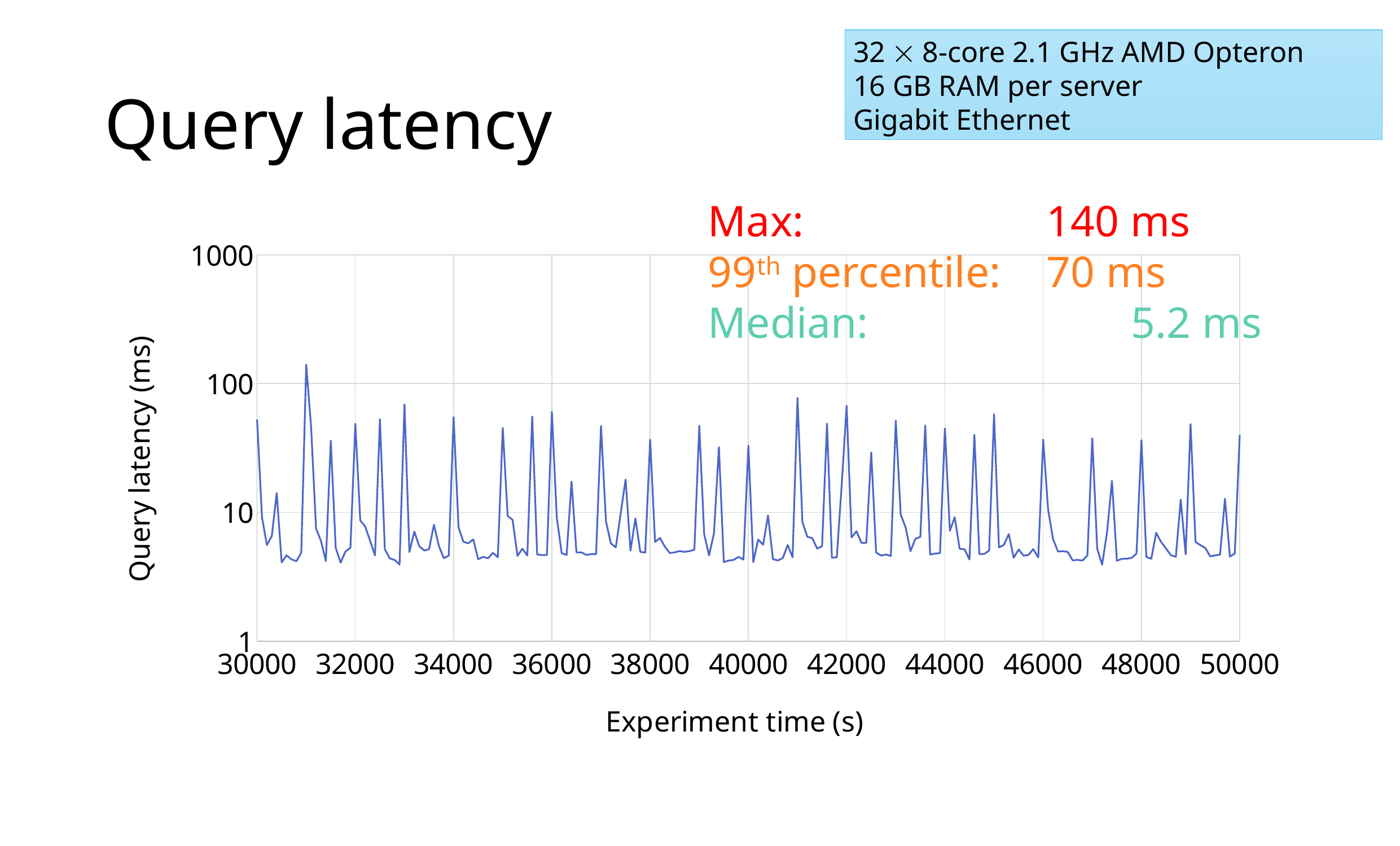
What kind of chart is shown on the slide? line chart What is the label of the x axis? Experiment time (s) Is the baseline query latency between spikes greater or less than 10 ms? less Which spike is higher: the one near 31000 s or the one near 33000 s? the one near 31000 s What is the label of the y axis? Query latency (ms) What is the difference between the maximum and the 99th percentile query latency? 70 ms What is the 99th percentile query latency stated on the slide? 70 ms Which is larger, the 99th percentile latency or the median latency? 99th percentile What is the maximum query latency stated on the slide? 140 ms How many data series are plotted in the chart? 1 Is the highest spike in the chart, near experiment time 31000 s, greater or less than 100 ms? greater What is the median query latency stated on the slide? 5.2 ms